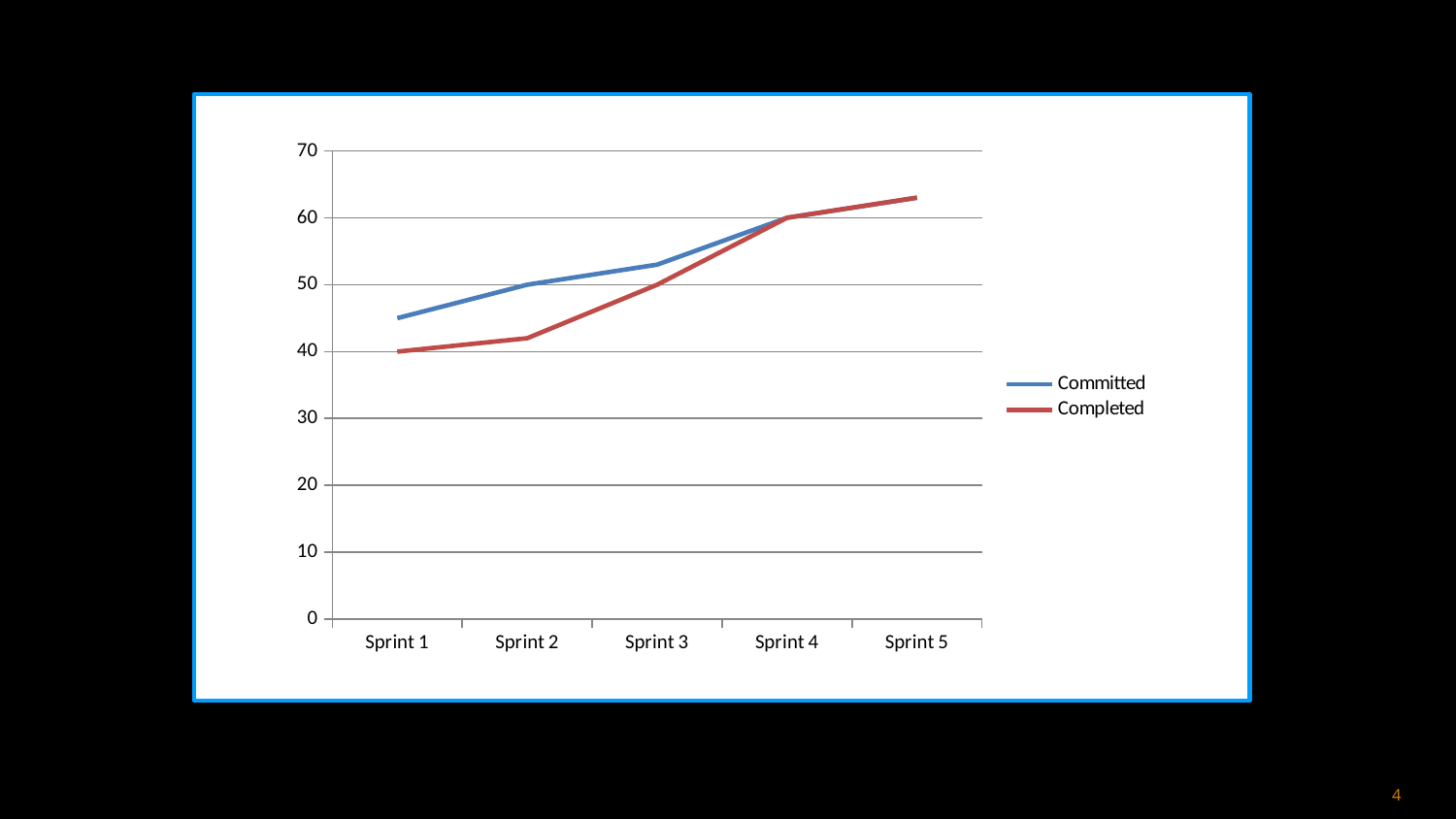
Is the Committed value for Sprint 1 greater or less than 40? greater How many series does the legend list? 2 What is the Completed value for Sprint 1? 40 Do the Completed values rise or fall from Sprint 1 to Sprint 5? rise In Sprint 1, which series has the larger value, Committed or Completed? Committed What kind of chart is shown on the slide? line chart What is the Committed value for Sprint 4? 60 How many sprints are shown on the x axis? 5 Is the Completed value for Sprint 5 greater or less than 60? greater What is the Committed value for Sprint 2? 50 What is the Completed value for Sprint 3? 50 Is the Completed value for Sprint 2 greater or less than 50? less